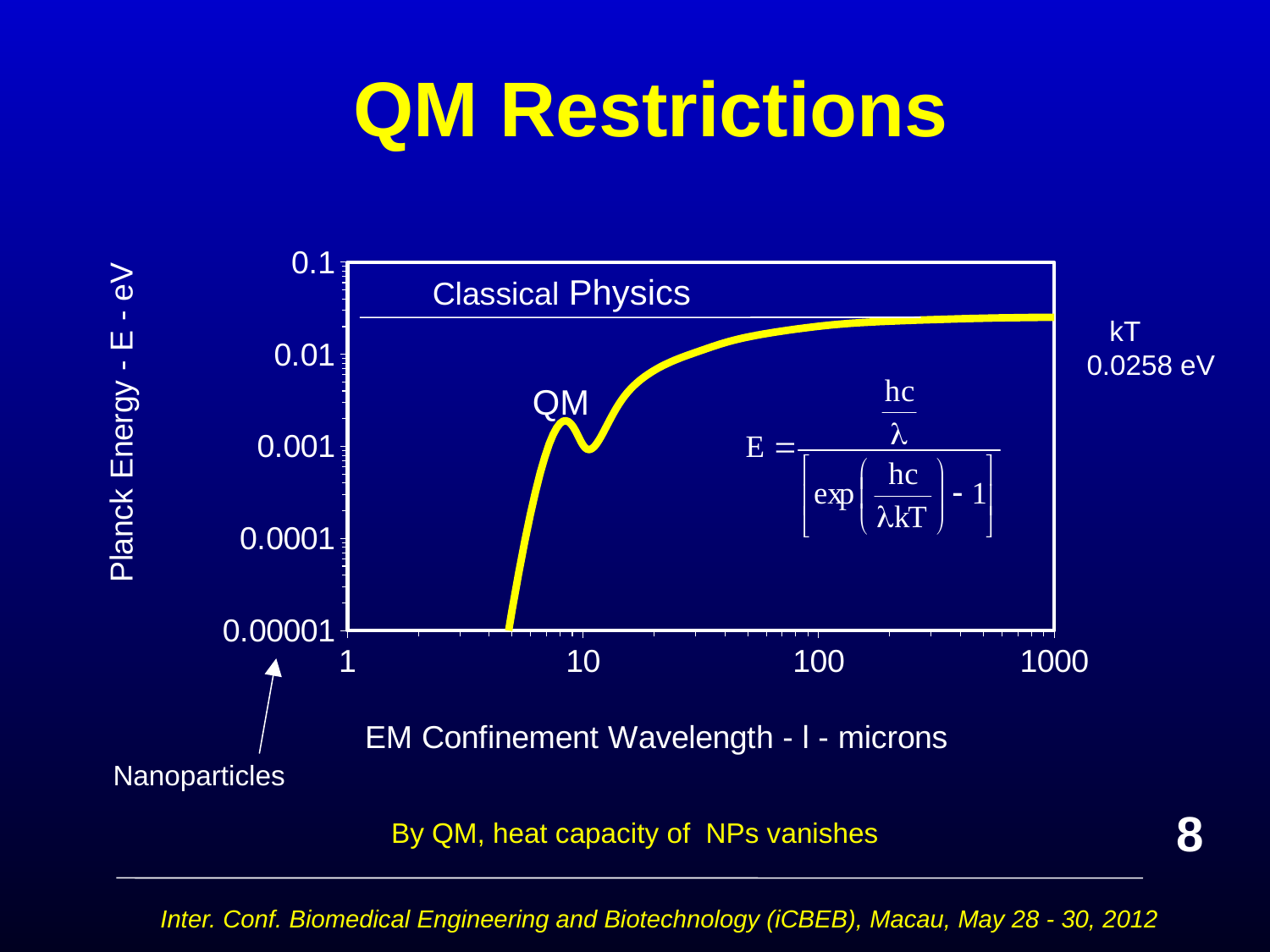
How many labelled tick marks are on the x axis of the chart? 4 What value of kT is printed next to the Classical Physics line? 0.0258 eV What kind of chart is shown on the slide? line chart What is the largest wavelength labelled on the x axis? 1000 What is the highest value labelled on the y axis? 0.1 What is the lowest value labelled on the y axis? 0.00001 What is the title of the slide containing the chart? QM Restrictions Does the QM curve rise or fall as the wavelength increases from 10 to 1000 microns? rise Is the value of the QM curve at 100 microns greater or less than 0.01? greater Is the value of the QM curve at 1000 microns greater or less than 0.1? less What is the label of the y axis of the chart? Planck Energy - E - eV At 10 microns, which is higher: the Classical Physics line or the QM curve? Classical Physics line